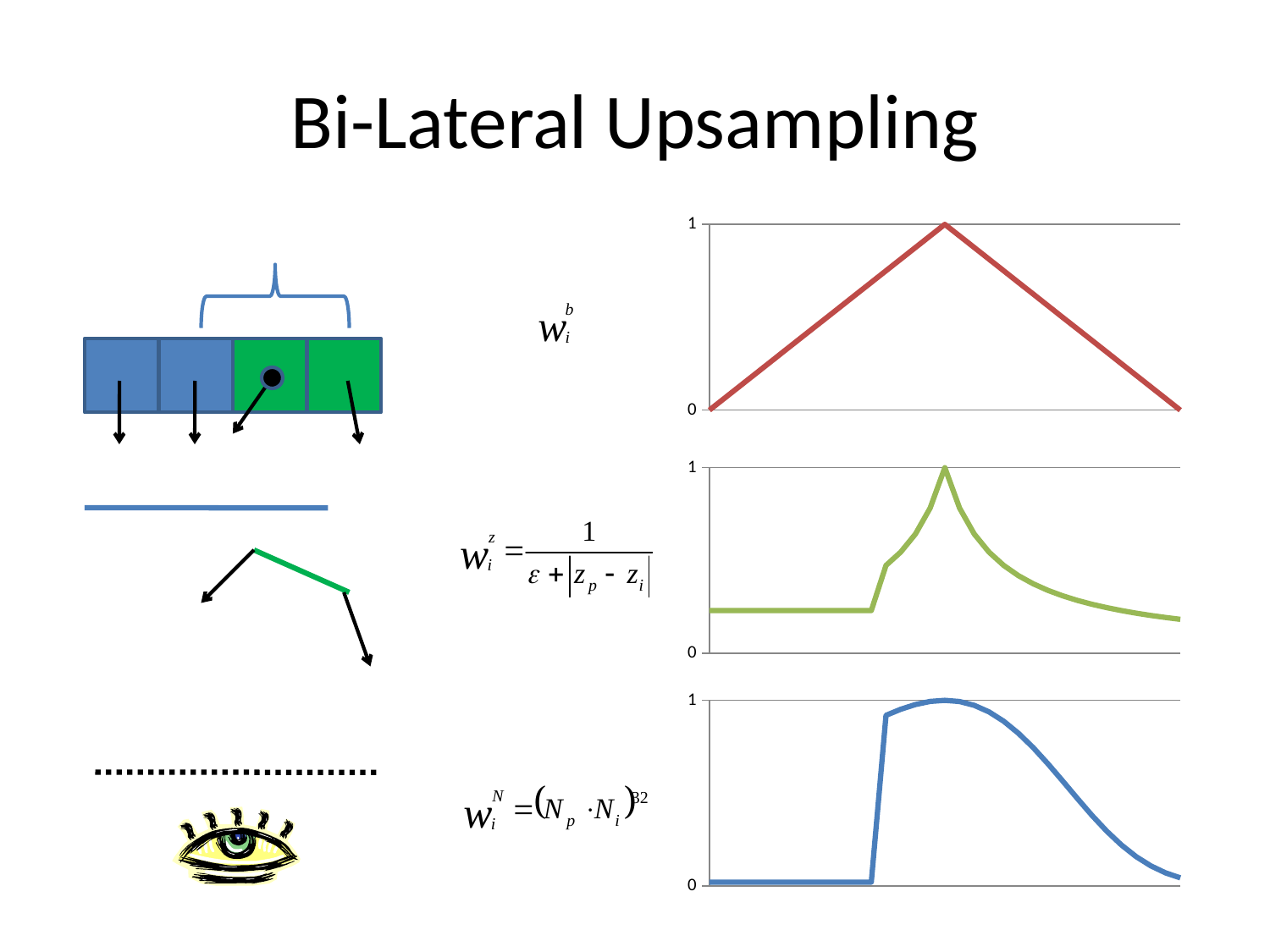
How many charts are shown on the slide? 3 In the top chart, does the line rise or fall from the left end to the middle? rise In the bottom chart, does the line rise or fall from the middle to the right end? fall In the middle chart, what value does the line reach at its peak? 1 What colour is the line in the bottom chart? blue In the top chart, what is the value of the line at its far left end? 0 In the top chart, what value does the line reach at its peak? 1 In the bottom chart, is the value of the line at the far left end greater or less than 1? less What kind of chart is the top chart on the right of the slide? line chart In the middle chart, is the value of the line at the far left end greater or less than 1? less In the top chart, what is the highest value shown on the y axis? 1 In the middle chart, is the value at the far right end greater or less than the peak value? less